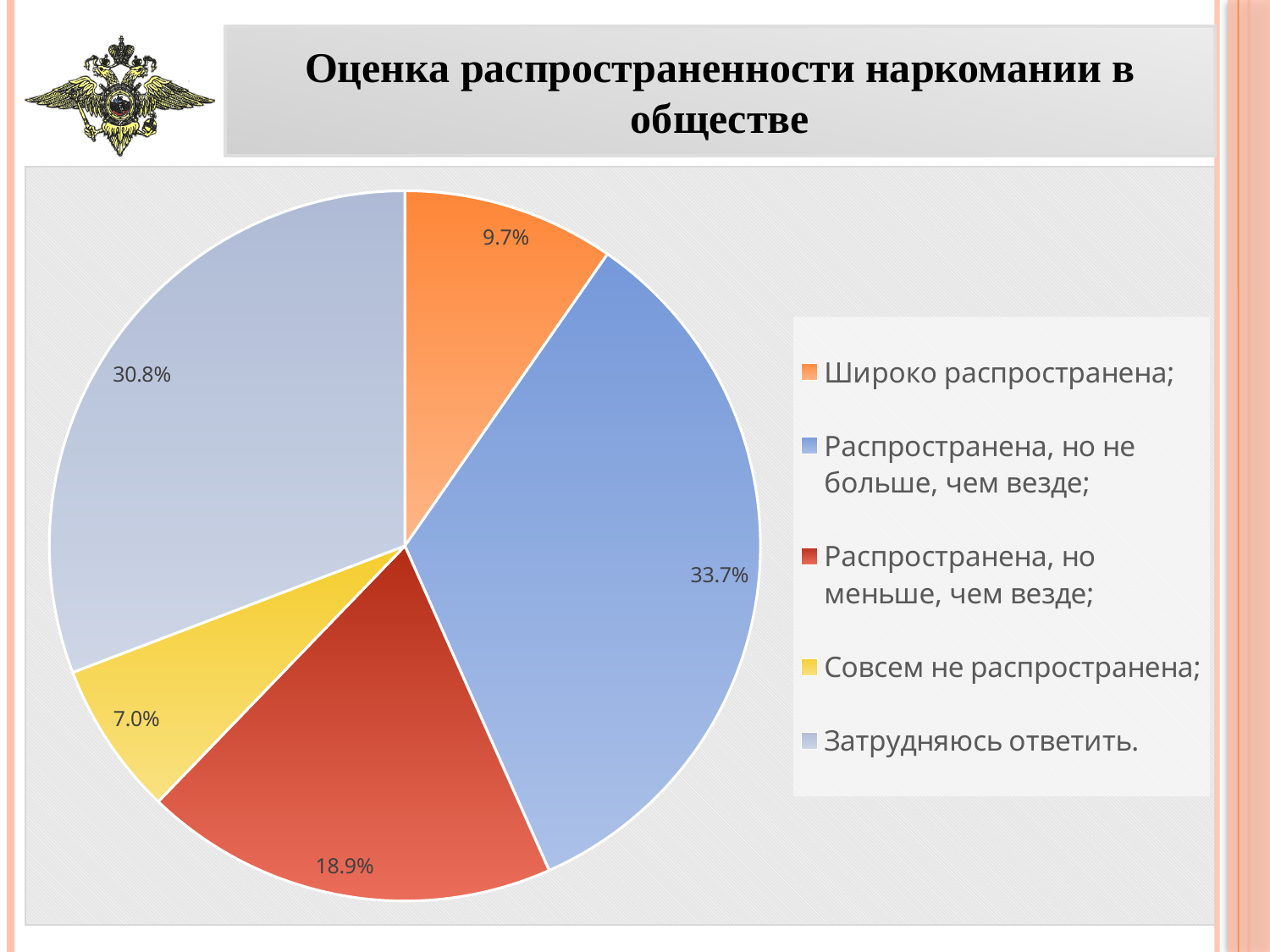
Which category has the largest share of the pie? Распространена, но не больше, чем везде Which category has the smallest share of the pie? Совсем не распространена What is the value for "Совсем не распространена"? 7.0% What is the value for "Распространена, но меньше, чем везде"? 18.9% Which is larger: the value for "Распространена, но меньше, чем везде" or the value for "Широко распространена"? Распространена, но меньше, чем везде What is the difference between the values for "Распространена, но не больше, чем везде" and "Затрудняюсь ответить"? 2.9% What is the value for "Распространена, но не больше, чем везде"? 33.7% What is the title of the chart on the slide? Оценка распространенности наркомании в обществе What is the value for "Затрудняюсь ответить"? 30.8% How many categories does the pie chart have? 5 What is the value for "Широко распространена"? 9.7% What kind of chart is shown on the slide? pie chart